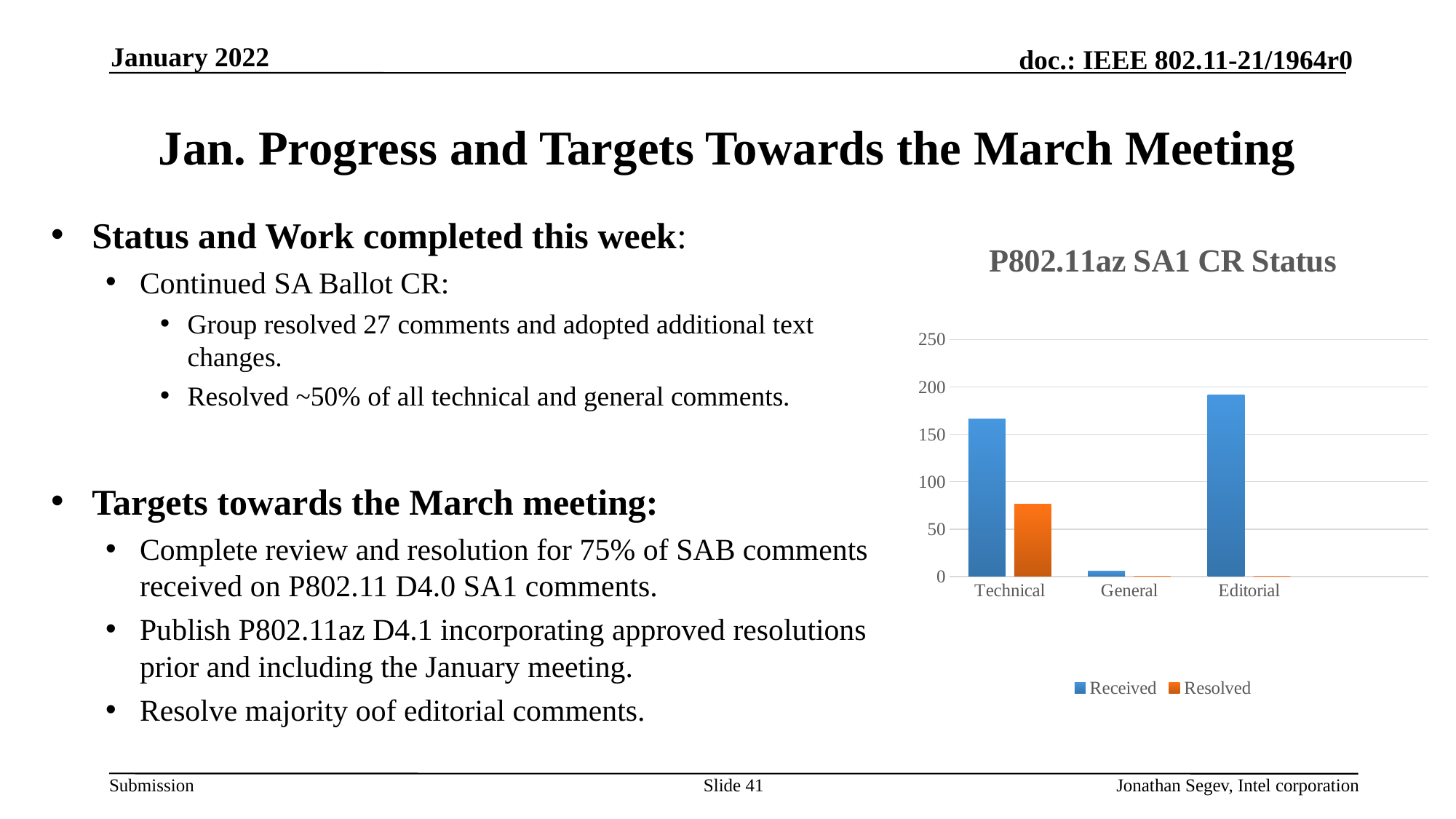
Is the Received value for General greater or less than 50? less Is the Received value for Technical greater or less than 150? greater How many categories are shown on the x axis of the chart? 3 Which category has the highest Received value? Editorial Which category has the highest Resolved value? Technical Is the Resolved value for Technical greater or less than 100? less For the Technical category, which is larger, Received or Resolved? Received What is the title of the chart? P802.11az SA1 CR Status What kind of chart is shown on the slide? bar chart How many series does the chart legend list? 2 Which colour represents the Resolved series in the chart? orange Which category has the lowest Received value? General